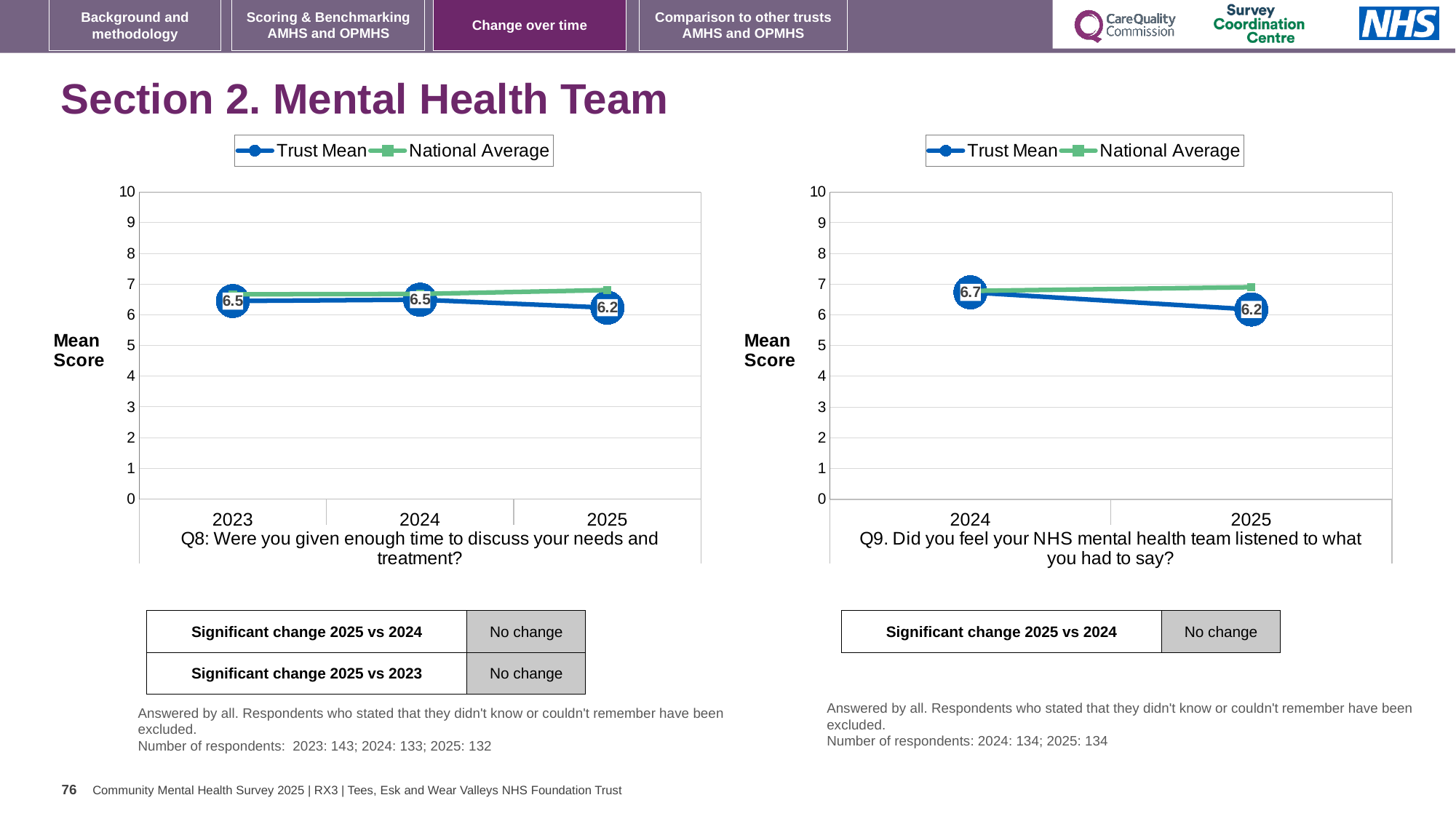
In the Q8 chart on the left, what is the Trust Mean for 2023? 6.5 How many series does the legend of the Q9 chart on the right list? 2 In the Q9 chart on the right, what is the Trust Mean for 2024? 6.7 In the Q9 chart on the right, by how much did the Trust Mean fall from 2024 to 2025? 0.5 In the Q8 chart on the left, which year has the lowest Trust Mean? 2025 In the Q9 chart on the right, what is the Trust Mean for 2025? 6.2 In the Q8 chart on the left, is the Trust Mean or the National Average higher in 2025? National Average In the Q8 chart on the left, what is the difference between the Trust Mean in 2024 and in 2025? 0.3 What kind of chart is the Q9 chart on the right? Line chart In the Q9 chart on the right, does the Trust Mean rise or fall from 2024 to 2025? Fall How many years are plotted on the x axis of the Q8 chart on the left? 3 In the Q8 chart on the left, what is the Trust Mean for 2025? 6.2